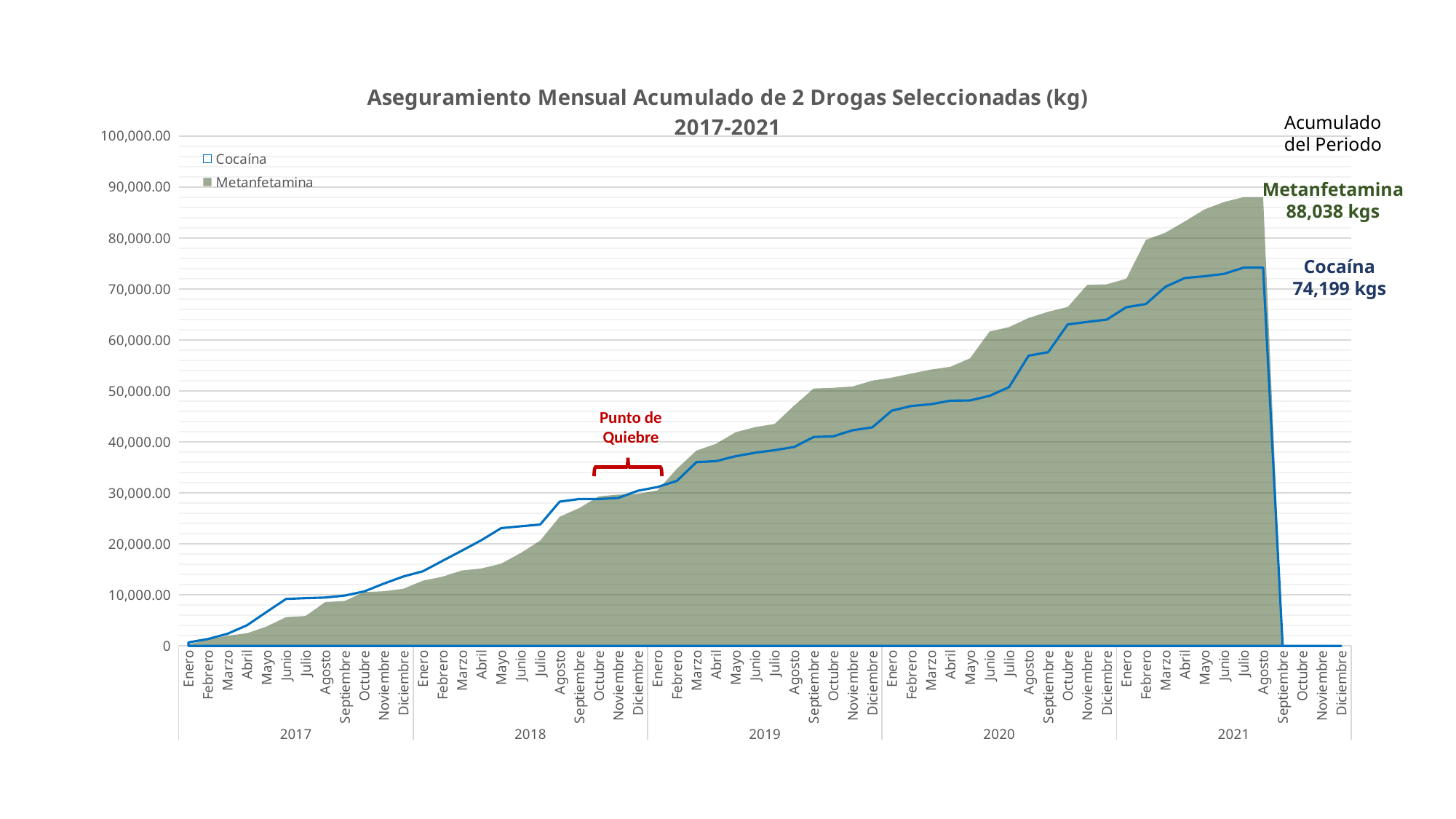
Which series is drawn as a shaded area rather than a line? Metanfetamina In which year is the 'Punto de Quiebre' annotation placed? 2018 Which drug has the higher accumulated total for the period, Metanfetamina or Cocaína? Metanfetamina What is the difference between the accumulated totals of Metanfetamina and Cocaína? 13,839 kgs What is the accumulated total for Metanfetamina shown on the chart? 88,038 kgs How many series does the legend list? 2 Is the value for Cocaína in Agosto 2021 greater or less than 70,000? greater How many years are labelled along the x axis? 5 What is the accumulated total for Cocaína shown on the chart? 74,199 kgs Is the value for Metanfetamina in Agosto 2021 greater or less than 80,000? greater Is the value for Metanfetamina in Junio 2017 greater or less than 10,000? less Do the cumulative values for Cocaína rise or fall from Enero 2017 to Agosto 2021? rise